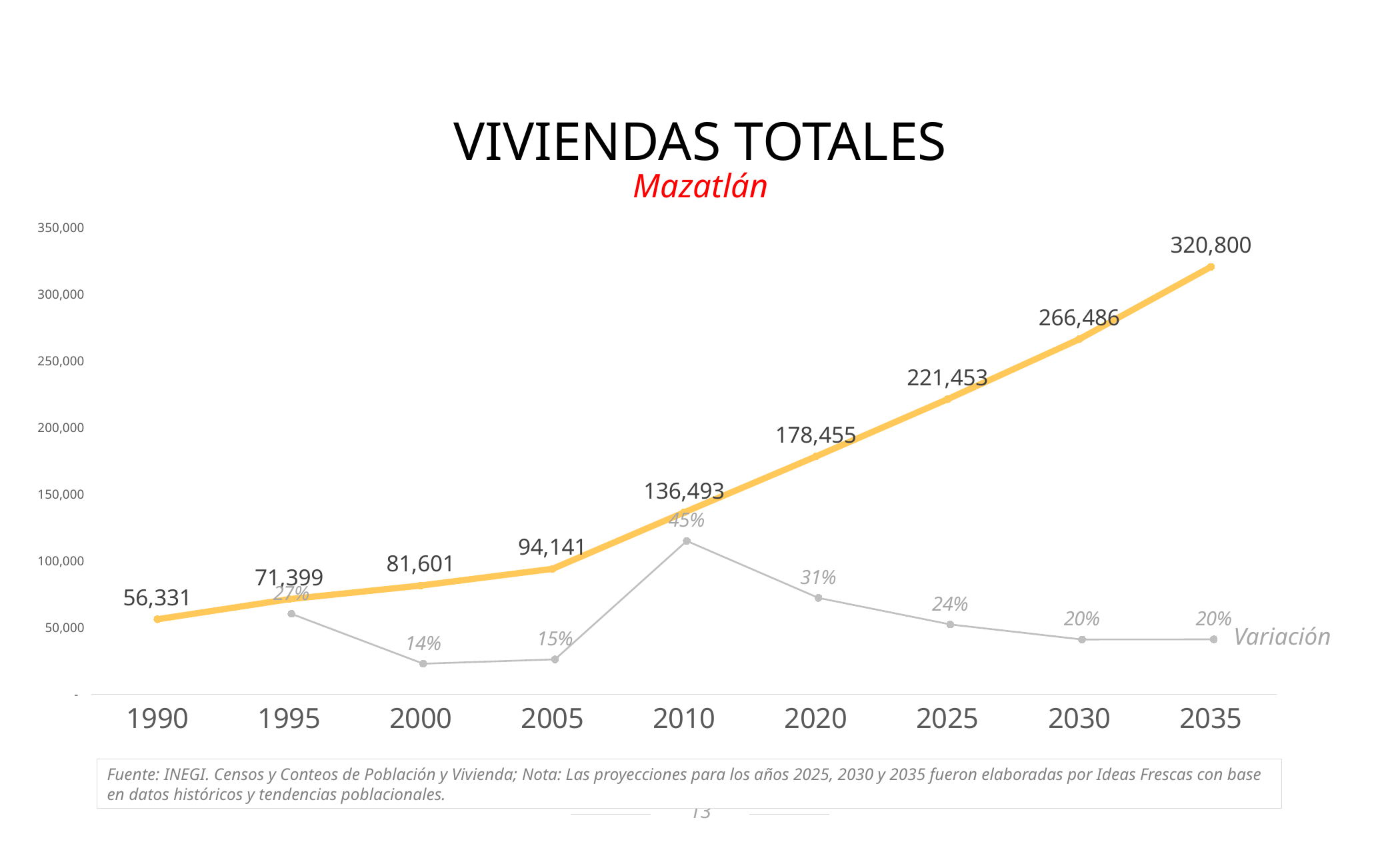
What is the Variación percentage shown for 2000? 14% Do the viviendas totales values rise or fall from 1990 to 2035? rise Which year has the highest value of viviendas totales? 2035 What is the Variación percentage shown for 2010? 45% What is the difference in viviendas totales between 2035 and 2030? 54,314 Which is larger, the Variación for 2020 or for 2025? 2020 How many years are shown on the x axis? 9 What kind of chart is shown on the slide? line chart Which year has the lowest Variación percentage? 2000 What is the value of viviendas totales for 2010? 136,493 Is the value of viviendas totales for 2025 greater or less than 200,000? greater What is the value of viviendas totales for 1990? 56,331